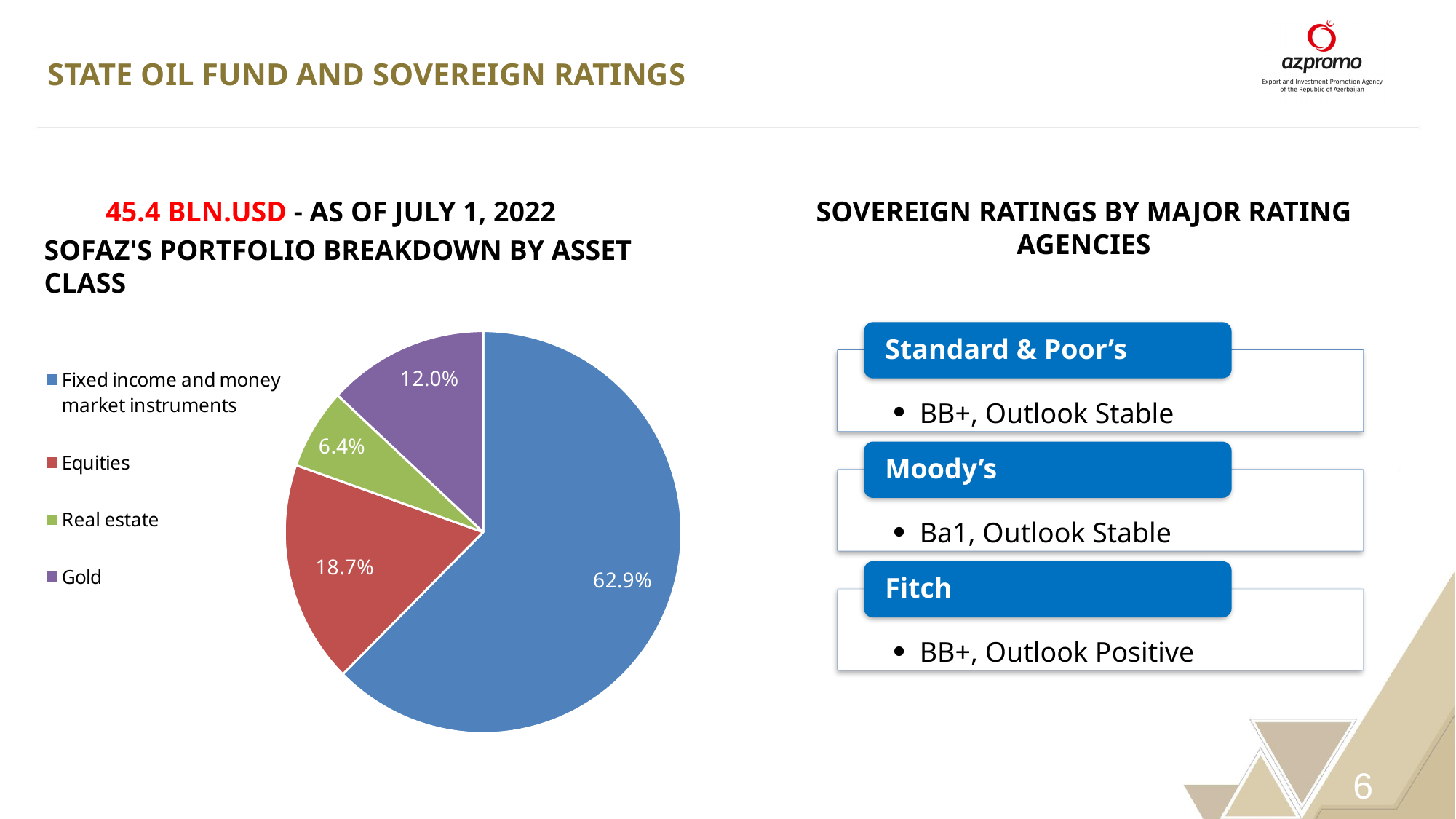
What share of SOFAZ's portfolio is in gold? 12.0% What is the difference in percentage points between the equities share and the gold share? 6.7 What share of SOFAZ's portfolio is in fixed income and money market instruments? 62.9% How many asset classes are shown in the pie chart? 4 What share of SOFAZ's portfolio is in equities? 18.7% What colour is the slice representing equities? Red Which asset class has the largest share of SOFAZ's portfolio? Fixed income and money market instruments What type of chart is used to show SOFAZ's portfolio breakdown? Pie chart Which asset class has the smallest share of SOFAZ's portfolio? Real estate What share of SOFAZ's portfolio is in real estate? 6.4% Which has a larger share of the portfolio, gold or real estate? Gold What is the total value of SOFAZ's portfolio as of July 1, 2022, according to the slide? 45.4 BLN.USD